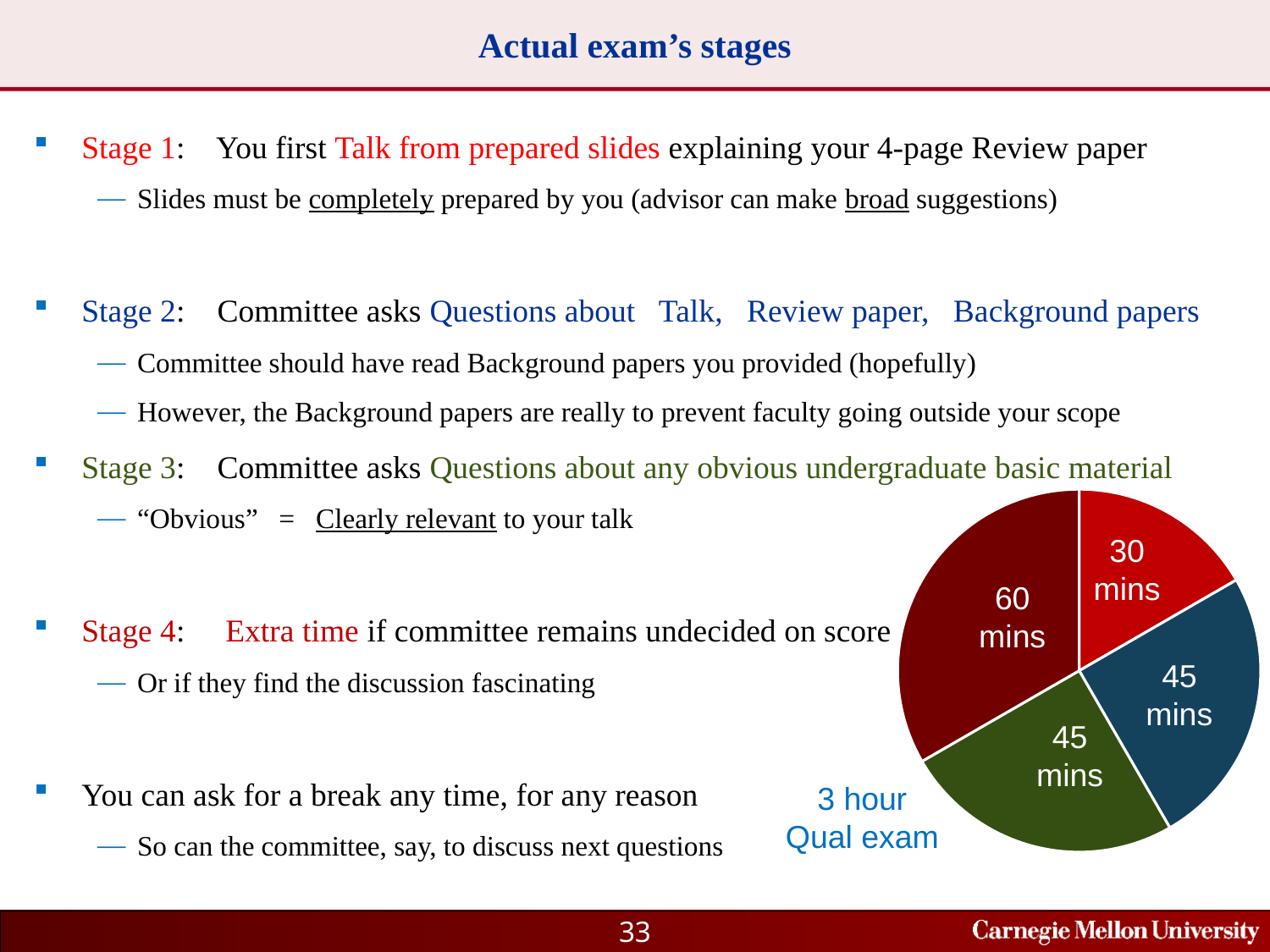
What is the total of all the slices in the pie chart, in minutes? 180 mins How many slices in the pie chart are labelled 45 mins? 2 What is the value of the smallest slice in the pie chart? 30 mins How many slices does the pie chart have? 4 What kind of chart is shown on the slide? pie chart What is the difference between the largest slice and the smallest slice in the pie chart? 30 mins What share of the pie does a 45 mins slice represent? 25% What is the value of the red slice in the pie chart? 30 mins What colour is the 60 mins slice in the pie chart? dark red What is the value of the largest slice in the pie chart? 60 mins Which is larger in the pie chart: the red slice or the dark red slice? the dark red slice What caption is written next to the pie chart? 3 hour Qual exam